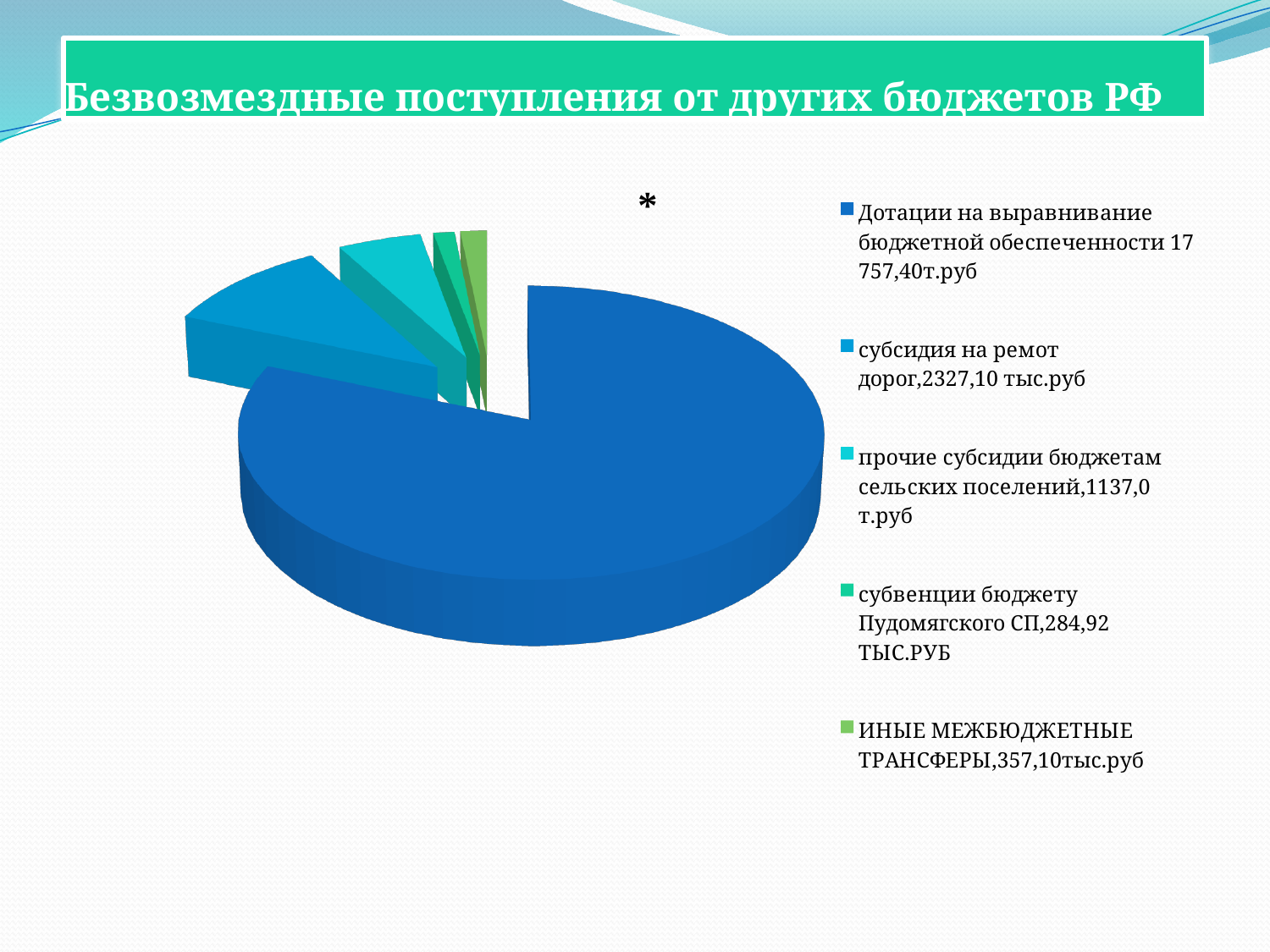
What is the value for 'субвенции бюджету Пудомягского СП'? 284,92 ТЫС.РУБ What is the value for 'субсидия на ремот дорог'? 2327,10 тыс.руб What is the difference between 'ИНЫЕ МЕЖБЮДЖЕТНЫЕ ТРАНСФЕРЫ' and 'субвенции бюджету Пудомягского СП'? 72,18 тыс.руб Which is larger: 'субсидия на ремот дорог' or 'прочие субсидии бюджетам сельских поселений'? субсидия на ремот дорог How many categories does the pie chart have? 5 What is the value for 'ИНЫЕ МЕЖБЮДЖЕТНЫЕ ТРАНСФЕРЫ'? 357,10тыс.руб What is the value for 'прочие субсидии бюджетам сельских поселений'? 1137,0 т.руб How many entries does the legend list? 5 What is the value for 'Дотации на выравнивание бюджетной обеспеченности'? 17 757,40т.руб What kind of chart is shown on the slide? Pie chart Which category has the smallest slice of the pie? субвенции бюджету Пудомягского СП Which category has the largest slice of the pie? Дотации на выравнивание бюджетной обеспеченности